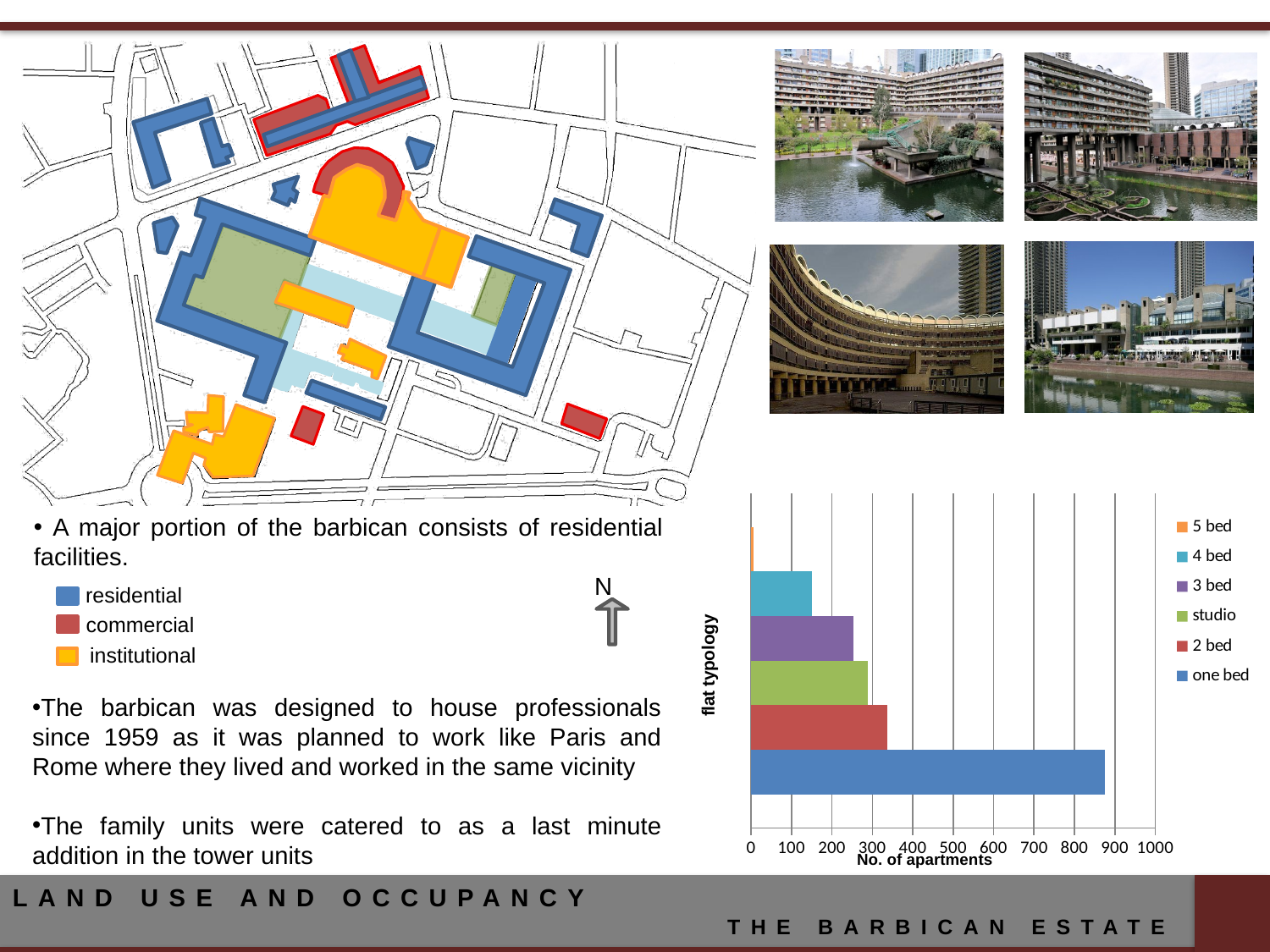
Which has more apartments, 3 bed or 4 bed? 3 bed Is the number of 3 bed apartments greater or less than 300? less What is the title of the horizontal axis of the chart? No. of apartments Which has more apartments, one bed or 2 bed? one bed What kind of chart is shown on the slide? bar chart Is the number of one bed apartments greater or less than 800? greater How many flat typologies does the legend list? 6 Is the number of 5 bed apartments greater or less than 100? less Which flat typology has the highest number of apartments? one bed Which flat typology has the lowest number of apartments? 5 bed